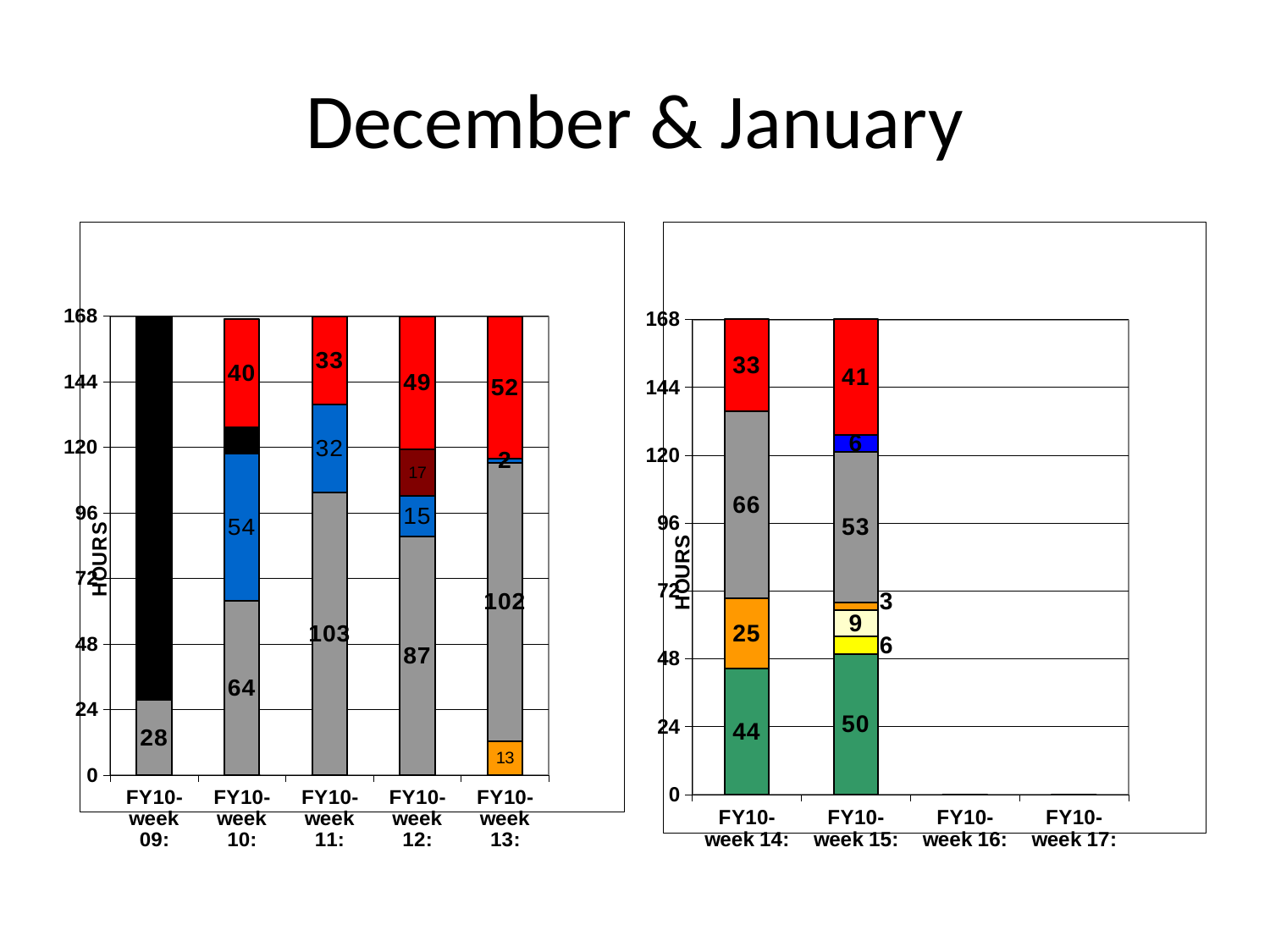
In the left chart, which week has the largest grey segment? FY10-week 11 What kind of chart is shown on the right side of the slide? Stacked bar chart In the left chart, what is the value of the grey segment for FY10-week 09? 28 In the right chart, what is the value of the orange segment for FY10-week 14? 25 In the right chart, what is the value of the green segment for FY10-week 15? 50 In the right chart, which is larger, the red segment for FY10-week 14 or for FY10-week 15? FY10-week 15 How many week categories are shown on the x axis of the left chart? 5 In the left chart, what is the value of the red segment for FY10-week 12? 49 What is the label on the vertical axis of the left chart? HOURS In the right chart, what is the total of the stacked bar for FY10-week 14? 168 In the left chart, what is the difference between the grey segments of FY10-week 11 and FY10-week 10? 39 In the left chart, what is the value of the blue segment for FY10-week 10? 54